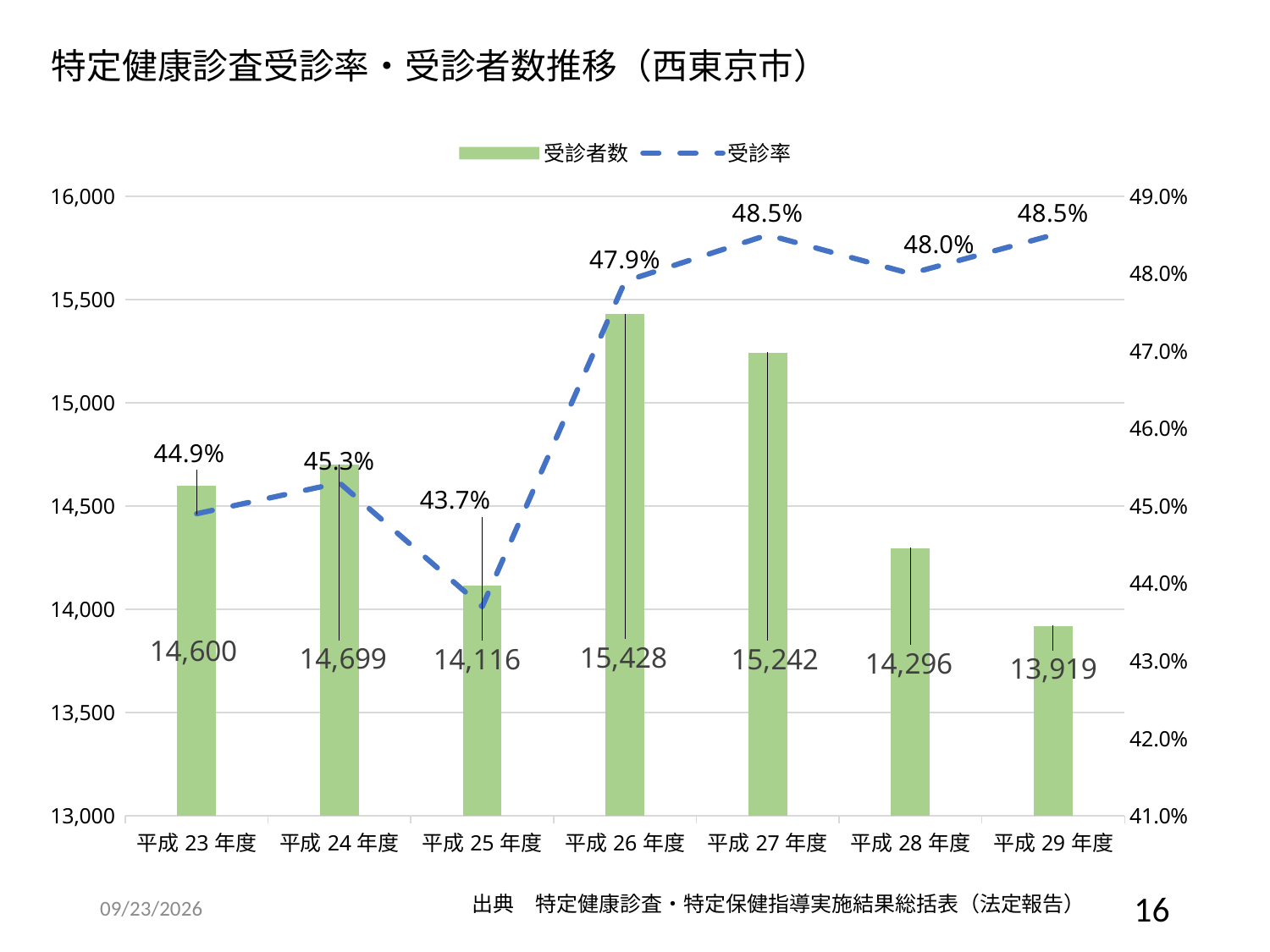
Which is larger, the 受診者数 for 平成 23 年度 or for 平成 28 年度? 平成 23 年度 How many years are shown on the x axis? 7 What is the 受診者数 value for 平成 29 年度? 13,919 How many series does the legend list? 2 Which year has the lowest 受診者数? 平成 29 年度 What is the difference in 受診率 between 平成 27 年度 and 平成 28 年度? 0.5% What is the difference in 受診者数 between 平成 26 年度 and 平成 27 年度? 186 Which year has the lowest 受診率? 平成 25 年度 What is the 受診者数 value for 平成 26 年度? 15,428 What is the title of the chart? 特定健康診査受診率・受診者数推移（西東京市） What is the 受診率 value for 平成 25 年度? 43.7% Which year has the highest 受診者数? 平成 26 年度